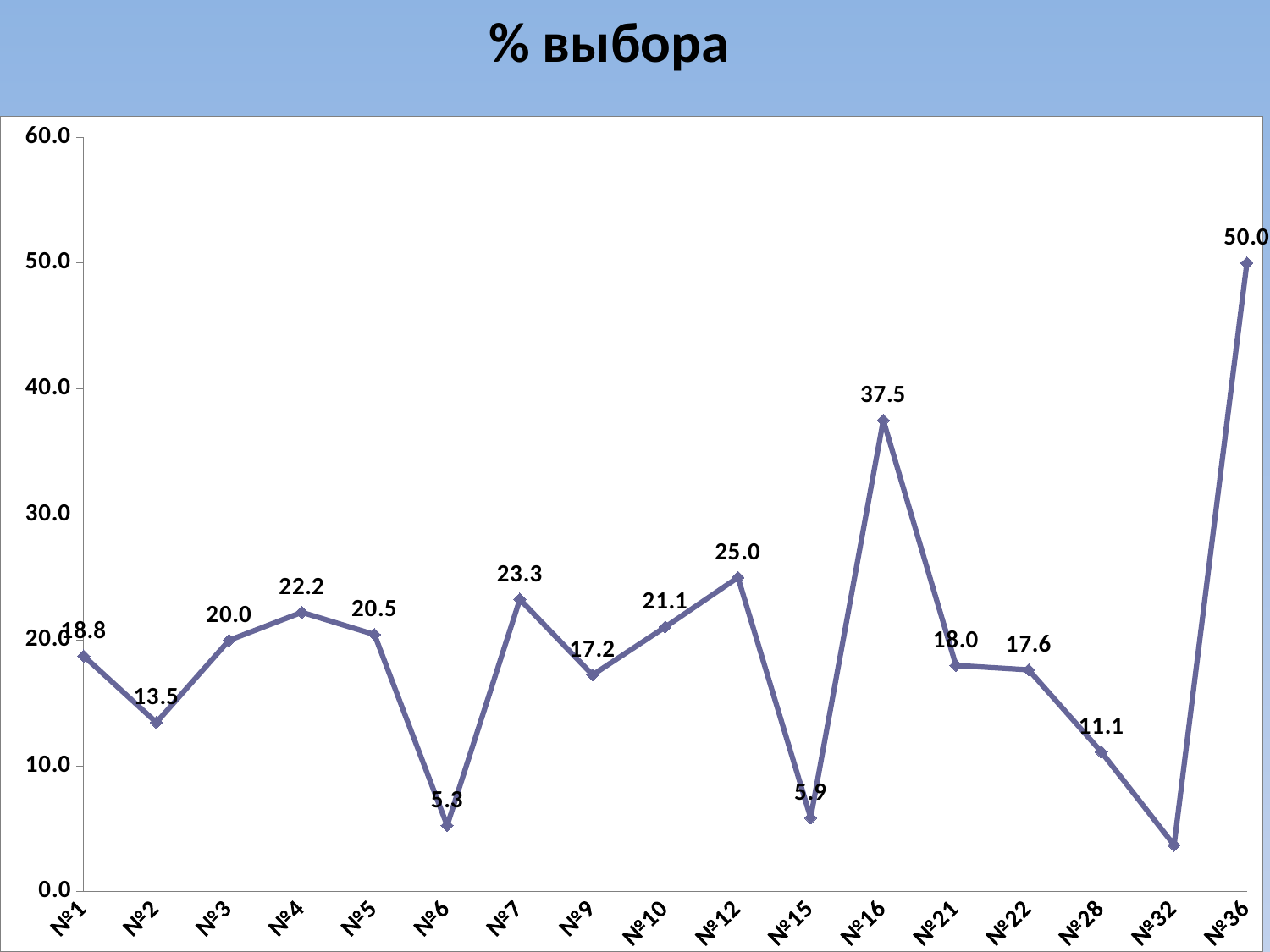
What is the value for №12? 25.0 How many categories are plotted on the x axis? 17 What is the value for №6? 5.3 Which is larger, the value for №7 or the value for №10? №7 Which category has the lowest value? №32 Does the value rise or fall from №28 to №32? fall What is the title of the chart? % выбора What type of chart is shown on the slide? line chart Is the value for №32 greater or less than 10.0? less What is the value for №16? 37.5 What is the difference between the values for №36 and №16? 12.5 Which category has the highest value? №36